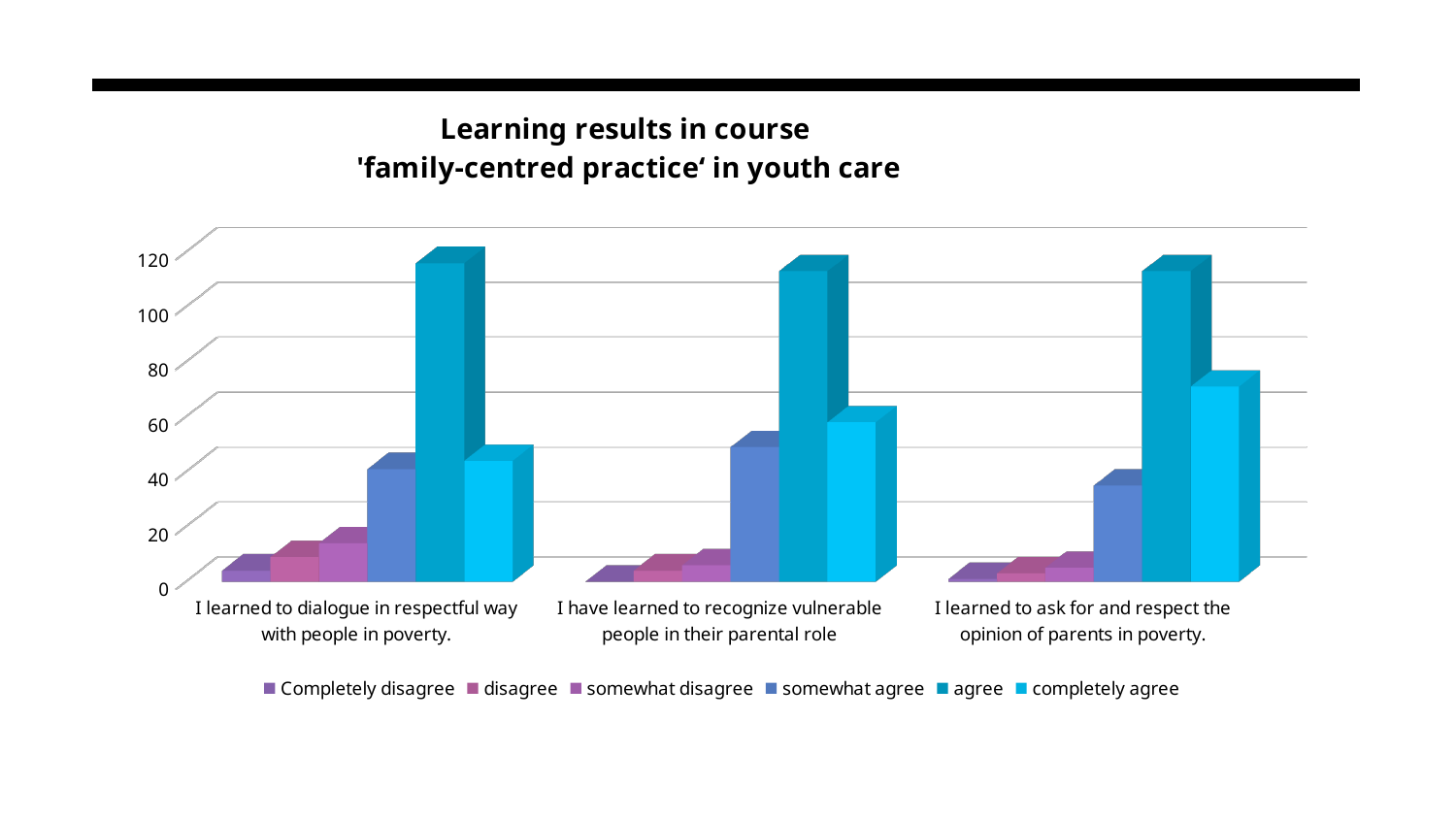
What kind of chart is shown on the slide? bar chart Which is larger: the 'completely agree' value for 'I learned to ask for and respect the opinion of parents in poverty.' or for 'I learned to dialogue in respectful way with people in poverty.'? I learned to ask for and respect the opinion of parents in poverty. How many series does the legend list? 6 For 'I have learned to recognize vulnerable people in their parental role', which is larger: 'agree' or 'completely agree'? agree Which response series has the lowest value for 'I learned to ask for and respect the opinion of parents in poverty.'? Completely disagree Is the value for 'somewhat agree' on 'I have learned to recognize vulnerable people in their parental role' greater or less than 40? greater Which response series has the highest value for 'I learned to dialogue in respectful way with people in poverty.'? agree What is the title of the chart? Learning results in course 'family-centred practice' in youth care Is the value for 'completely agree' on 'I learned to ask for and respect the opinion of parents in poverty.' greater or less than 60? greater Is the value for 'completely agree' on 'I learned to dialogue in respectful way with people in poverty.' greater or less than 60? less How many statement categories are shown on the x axis? 3